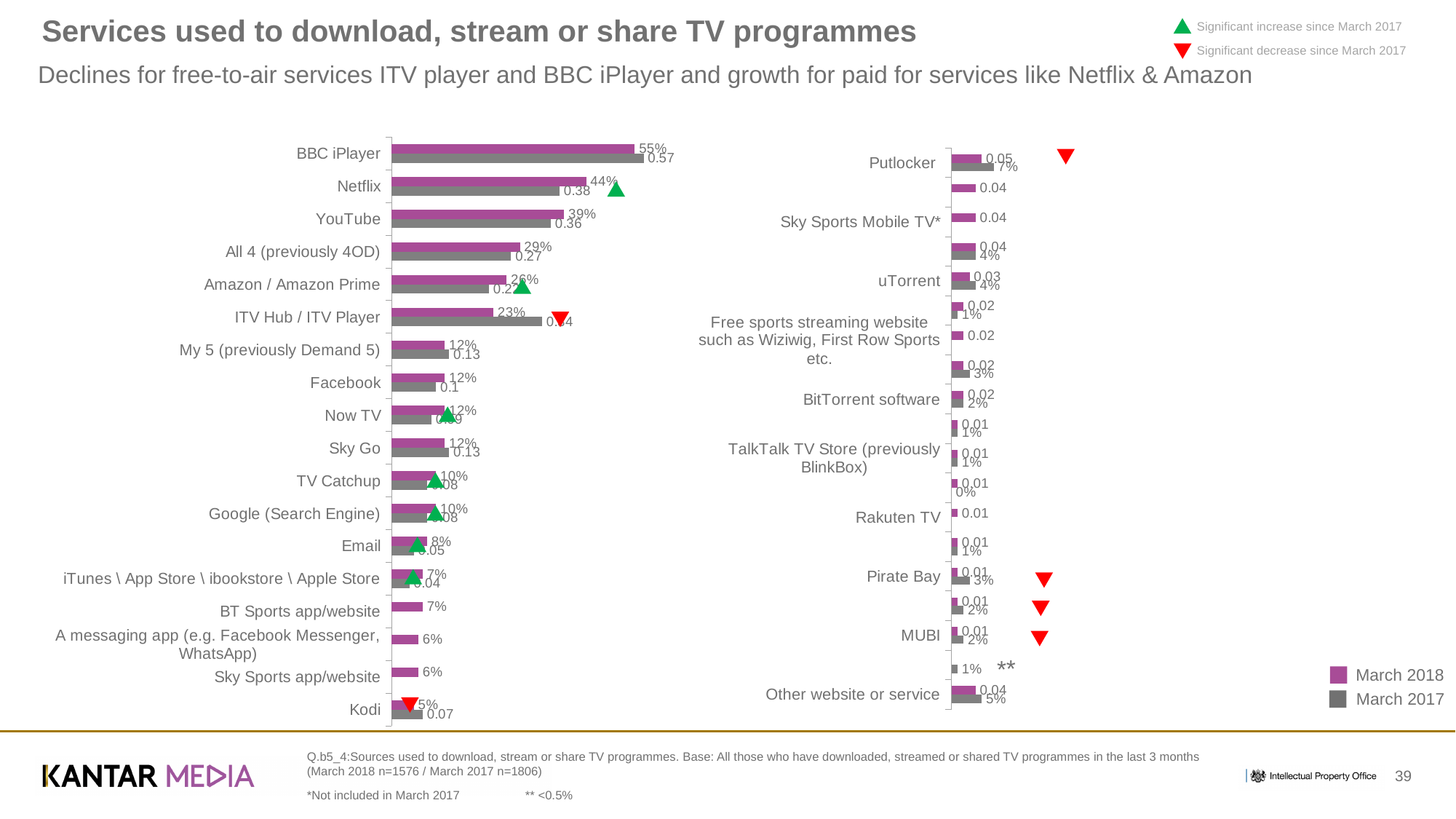
On the left chart, which has the larger March 2018 value, YouTube or All 4 (previously 4OD)? YouTube On the left chart, what is the difference between the March 2018 values for BBC iPlayer and Netflix? 11 percentage points How many categories are shown on the left chart? 18 On the left chart, what is the March 2018 value for Kodi? 5% How many series does the legend list? 2 On the left chart, what is the March 2017 value for Netflix? 0.38 On the right chart, what is the March 2017 value for Putlocker? 7% Which colour represents March 2018 in the legend? Purple What kind of chart is the left chart? Bar chart On the left chart, which service has the highest March 2018 value? BBC iPlayer On the right chart, what is the March 2018 value for uTorrent? 0.03 On the left chart, what is the March 2018 value for BBC iPlayer? 55%